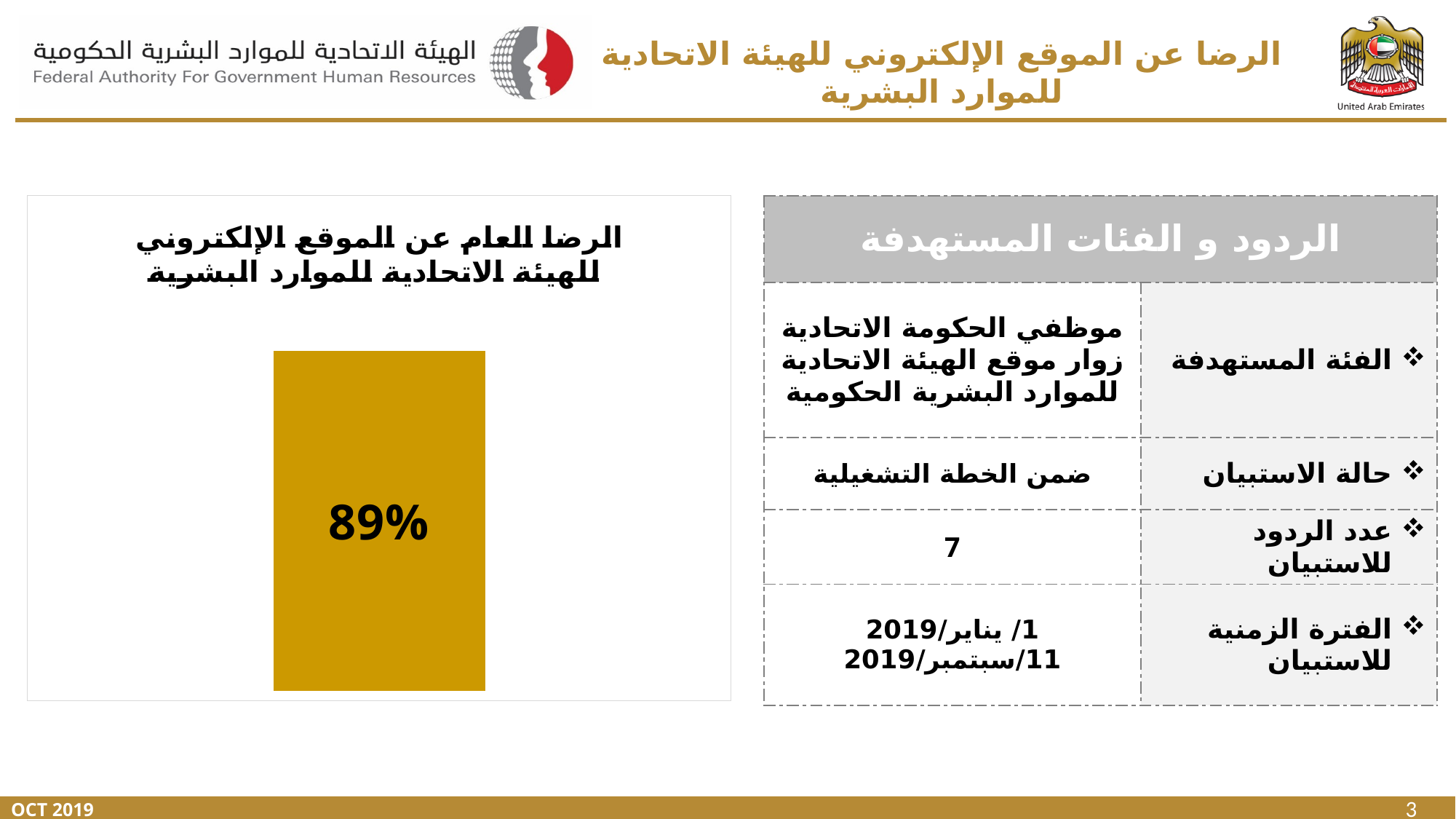
What colour is the bar in the chart? Gold (dark yellow) What is the title of the chart? الرضا العام عن الموقع الإلكتروني للهيئة الاتحادية للموارد البشرية What is the overall satisfaction with the website of the Federal Authority for Government Human Resources, as shown in the chart? 89% What kind of chart is shown on the slide? Bar chart How many bars does the chart contain? 1 What value is shown on the bar in the chart? 89%